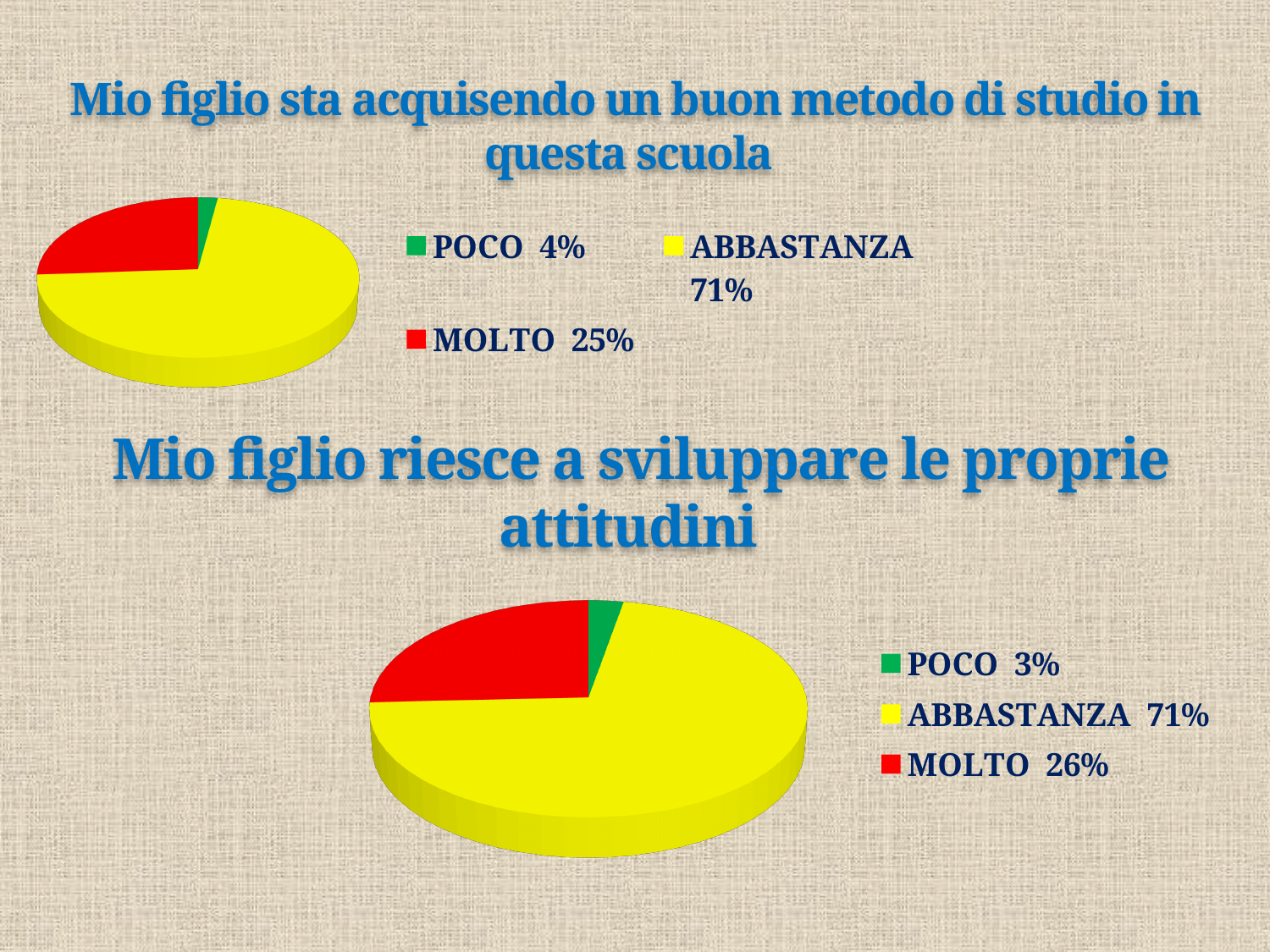
In the top chart ('Mio figlio sta acquisendo un buon metodo di studio in questa scuola'), what share is labelled for MOLTO? 25% In the bottom chart ('Mio figlio riesce a sviluppare le proprie attitudini'), what is the difference between the MOLTO and POCO shares? 23% In the top chart ('Mio figlio sta acquisendo un buon metodo di studio in questa scuola'), what is the difference between the ABBASTANZA and MOLTO shares? 46% In the bottom chart ('Mio figlio riesce a sviluppare le proprie attitudini'), what share is labelled for MOLTO? 26% In the bottom chart ('Mio figlio riesce a sviluppare le proprie attitudini'), is the MOLTO share larger or smaller than the POCO share? Larger In the top chart ('Mio figlio sta acquisendo un buon metodo di studio in questa scuola'), what share is labelled for ABBASTANZA? 71% In the bottom chart ('Mio figlio riesce a sviluppare le proprie attitudini'), which category has the largest slice? ABBASTANZA In the bottom chart ('Mio figlio riesce a sviluppare le proprie attitudini'), what share is labelled for POCO? 3% In the top chart ('Mio figlio sta acquisendo un buon metodo di studio in questa scuola'), what colour is the MOLTO slice? Red In the bottom chart ('Mio figlio riesce a sviluppare le proprie attitudini'), how many categories does the legend list? 3 What kind of chart is the top chart ('Mio figlio sta acquisendo un buon metodo di studio in questa scuola')? Pie chart In the top chart ('Mio figlio sta acquisendo un buon metodo di studio in questa scuola'), which category has the smallest slice? POCO